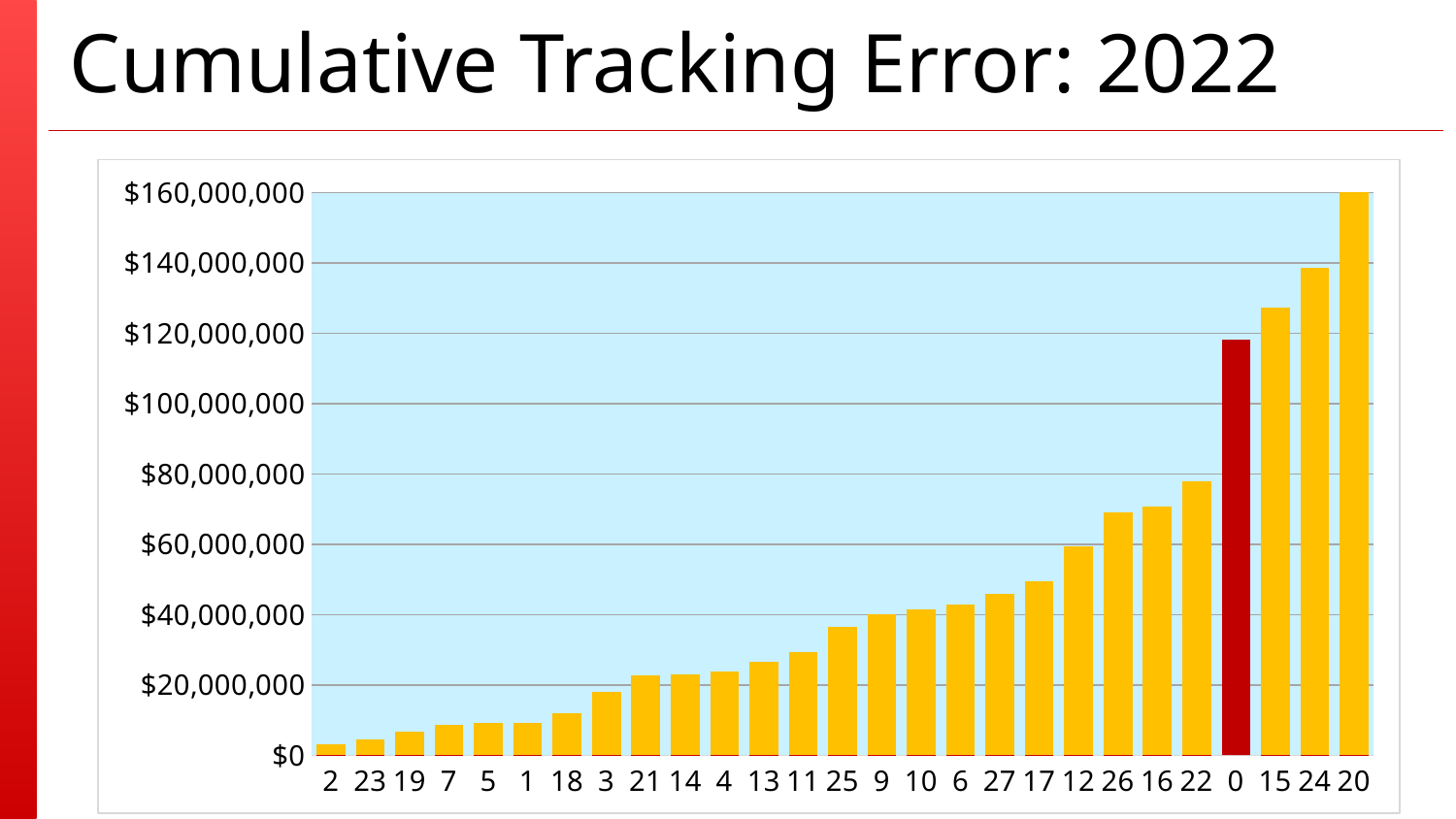
What kind of chart is shown on the slide? bar chart How many categories are plotted on the x axis? 27 Which category has the lowest cumulative tracking error? 2 Do the bar values rise or fall moving from left to right along the x axis? rise Which has the larger value, category 9 or category 4? 9 Is the value for category 15 greater or less than $120,000,000? greater Which category has the highest cumulative tracking error? 20 Which has the larger value, category 15 or category 0? 15 Is the value for category 0 greater or less than $100,000,000? greater Which category's bar is coloured dark red instead of yellow? 0 Is the value for category 3 greater or less than $20,000,000? less